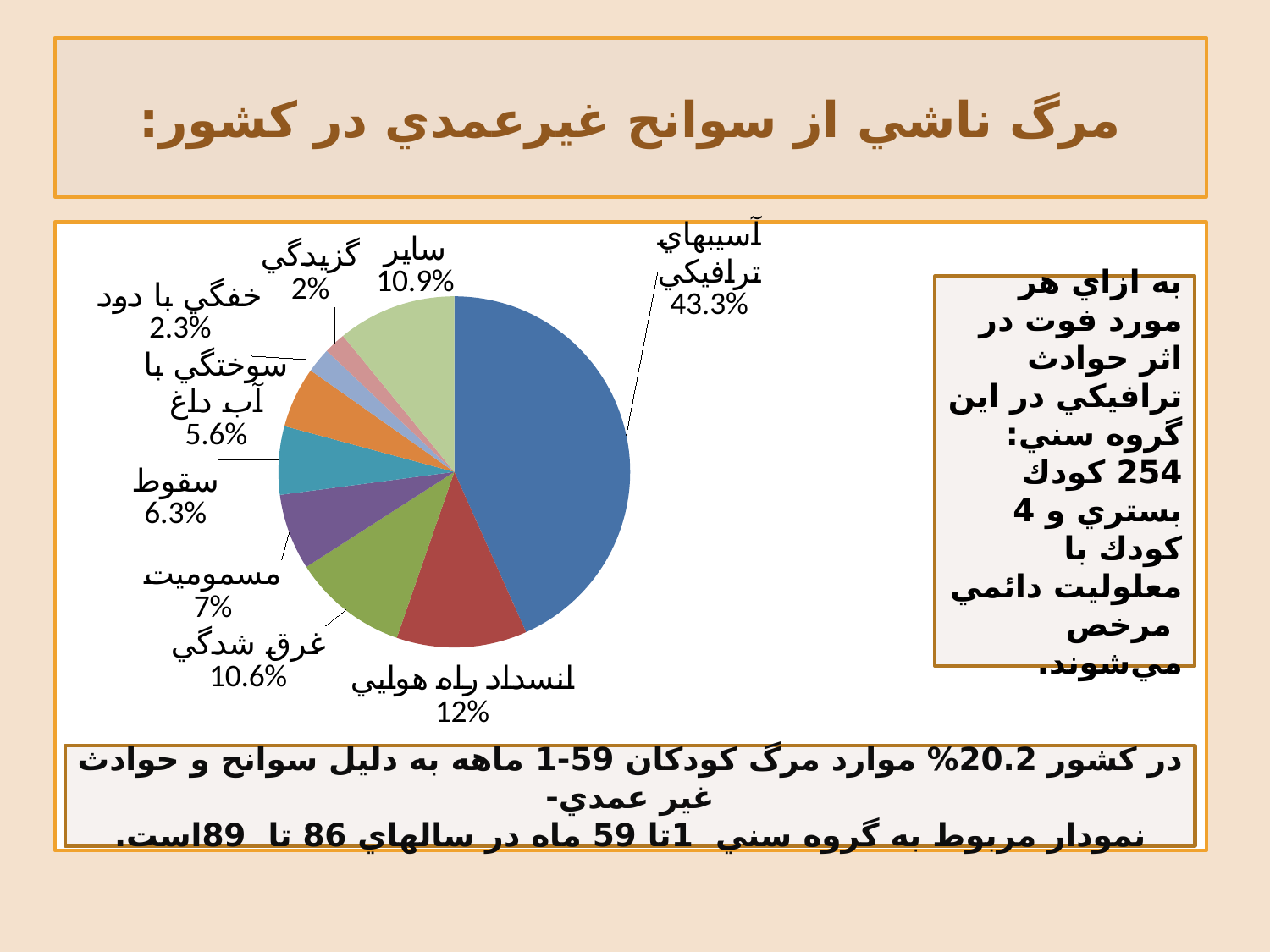
What percentage does the slice for سقوط show? 6.3% Which category has the smallest share of the pie? گزيدگي What percentage does the slice for آسيبهاي ترافيكي show? 43.3% What percentage does the slice for انسداد راه هوايي show? 12% How many slices does the pie chart have? 9 What percentage does the slice for غرق شدگي show? 10.6% What is the difference in percentage points between آسيبهاي ترافيكي and انسداد راه هوايي? 31.3 What percentage does the slice for خفگي با دود show? 2.3% Which category has the largest share of the pie? آسيبهاي ترافيكي What is the title of the slide containing the pie chart? مرگ ناشي از سوانح غيرعمدي در كشور: What kind of chart is shown on the slide? pie chart Which is larger, the share for مسمومیت or the share for سوختگي با آب داغ? مسمومیت